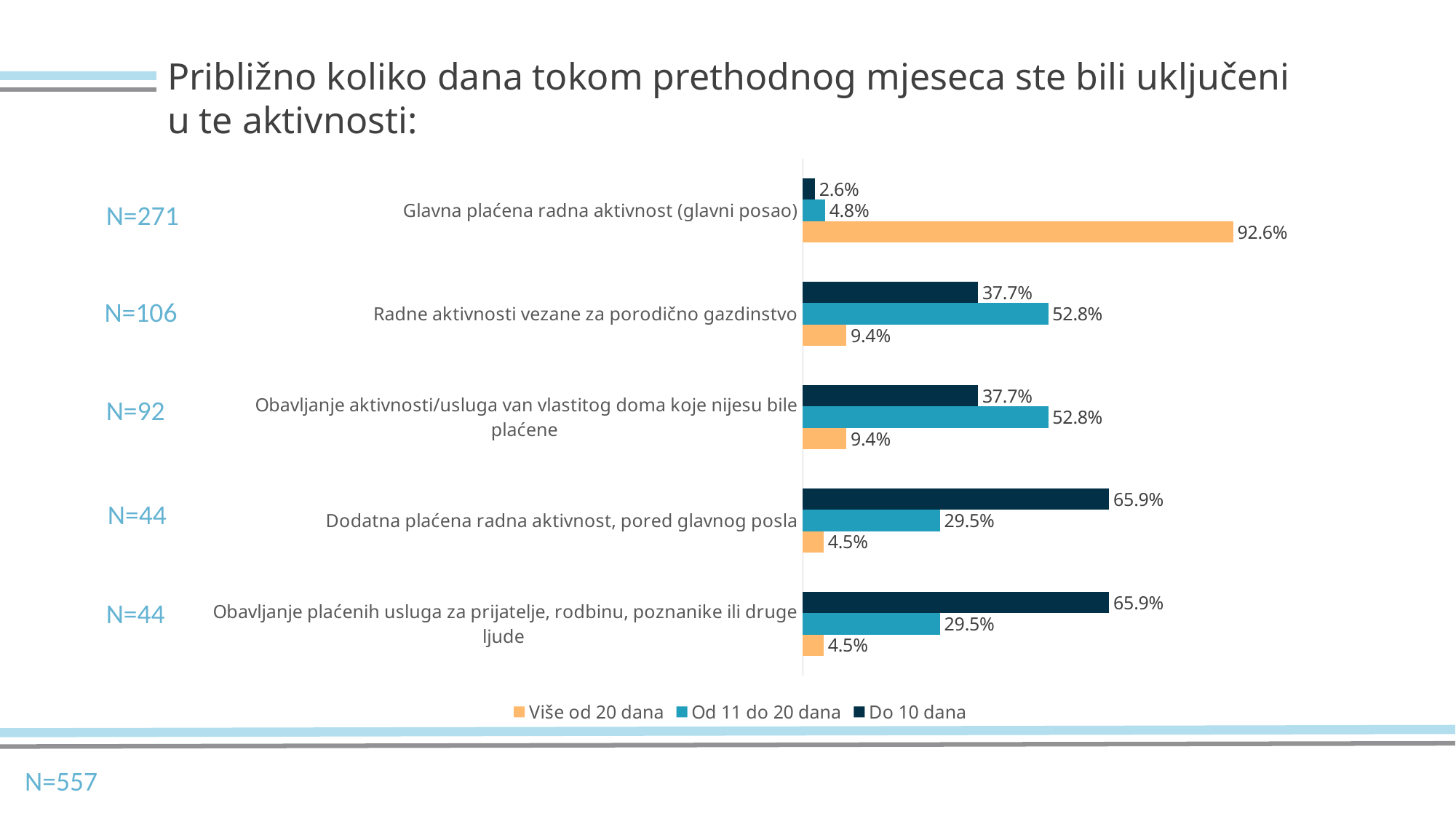
What is the 'Do 10 dana' value for 'Dodatna plaćena radna aktivnost, pored glavnog posla'? 65.9% Which activity has the highest 'Više od 20 dana' percentage? Glavna plaćena radna aktivnost (glavni posao) For 'Radne aktivnosti vezane za porodično gazdinstvo', which is larger: 'Do 10 dana' or 'Od 11 do 20 dana'? Od 11 do 20 dana What percentage of respondents in 'Glavna plaćena radna aktivnost (glavni posao)' reported 'Više od 20 dana'? 92.6% What is the 'Od 11 do 20 dana' value for 'Radne aktivnosti vezane za porodično gazdinstvo'? 52.8% How many series does the legend list? 3 What is the sample size (N) shown for 'Glavna plaćena radna aktivnost (glavni posao)'? N=271 How many activity categories are shown in the chart? 5 What type of chart is shown on the slide? Bar chart What is the 'Više od 20 dana' value for 'Obavljanje plaćenih usluga za prijatelje, rodbinu, poznanike ili druge ljude'? 4.5% What is the difference between the 'Do 10 dana' and 'Od 11 do 20 dana' values for 'Dodatna plaćena radna aktivnost, pored glavnog posla'? 36.4% Which activity has the lowest 'Do 10 dana' percentage? Glavna plaćena radna aktivnost (glavni posao)